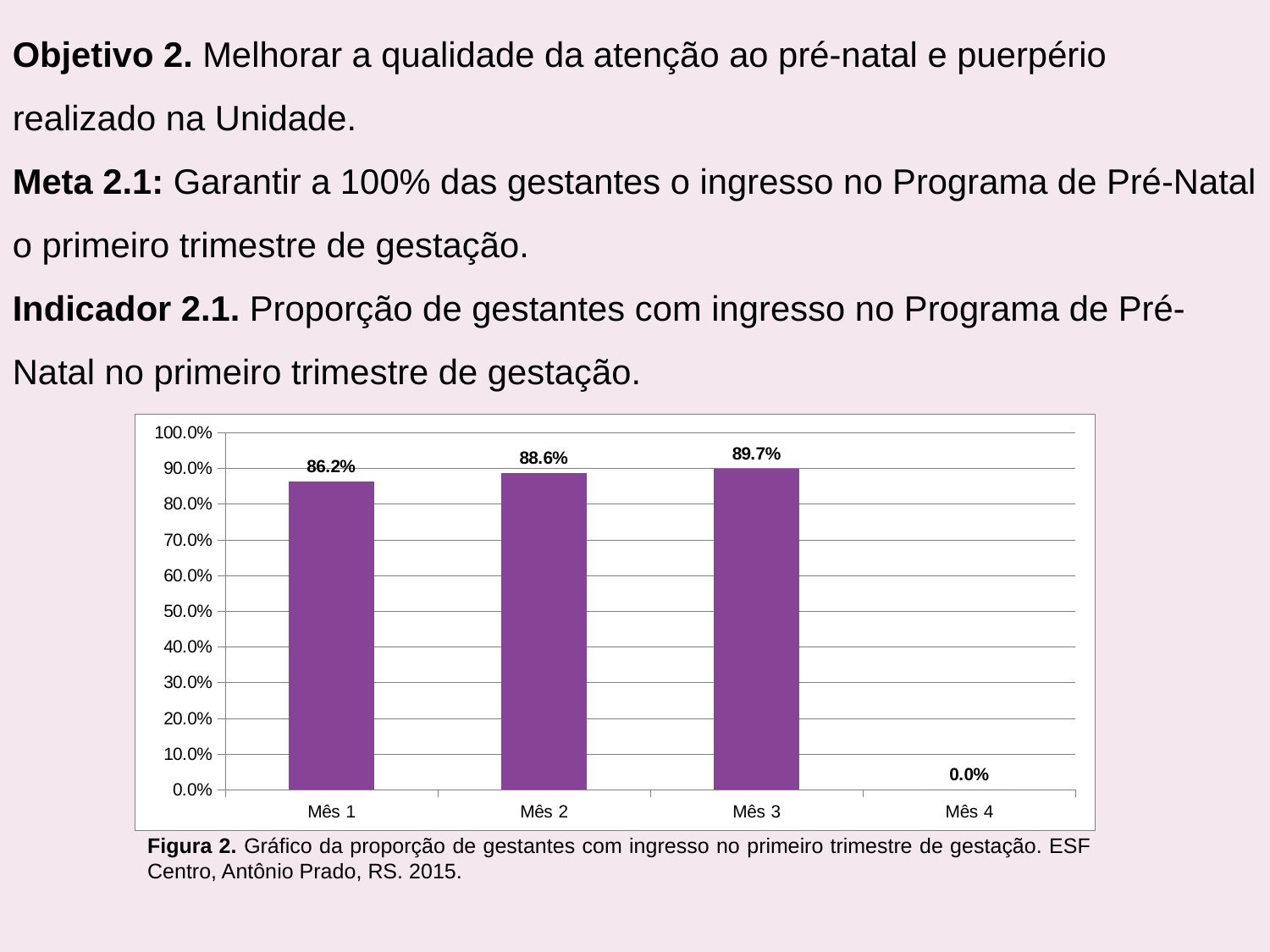
Which month has the highest value? Mês 3 Which month has the lowest value? Mês 4 What is the difference between the values for Mês 3 and Mês 1? 3.5% Do the values rise or fall from Mês 1 to Mês 3? rise What is the value for Mês 2? 88.6% What is the value for Mês 3? 89.7% What is the value for Mês 1? 86.2% What kind of chart is shown? bar chart Is the value for Mês 2 greater or less than 80.0%? greater How many months are shown on the x axis? 4 What is the value for Mês 4? 0.0% Which is larger, the value for Mês 2 or the value for Mês 1? Mês 2